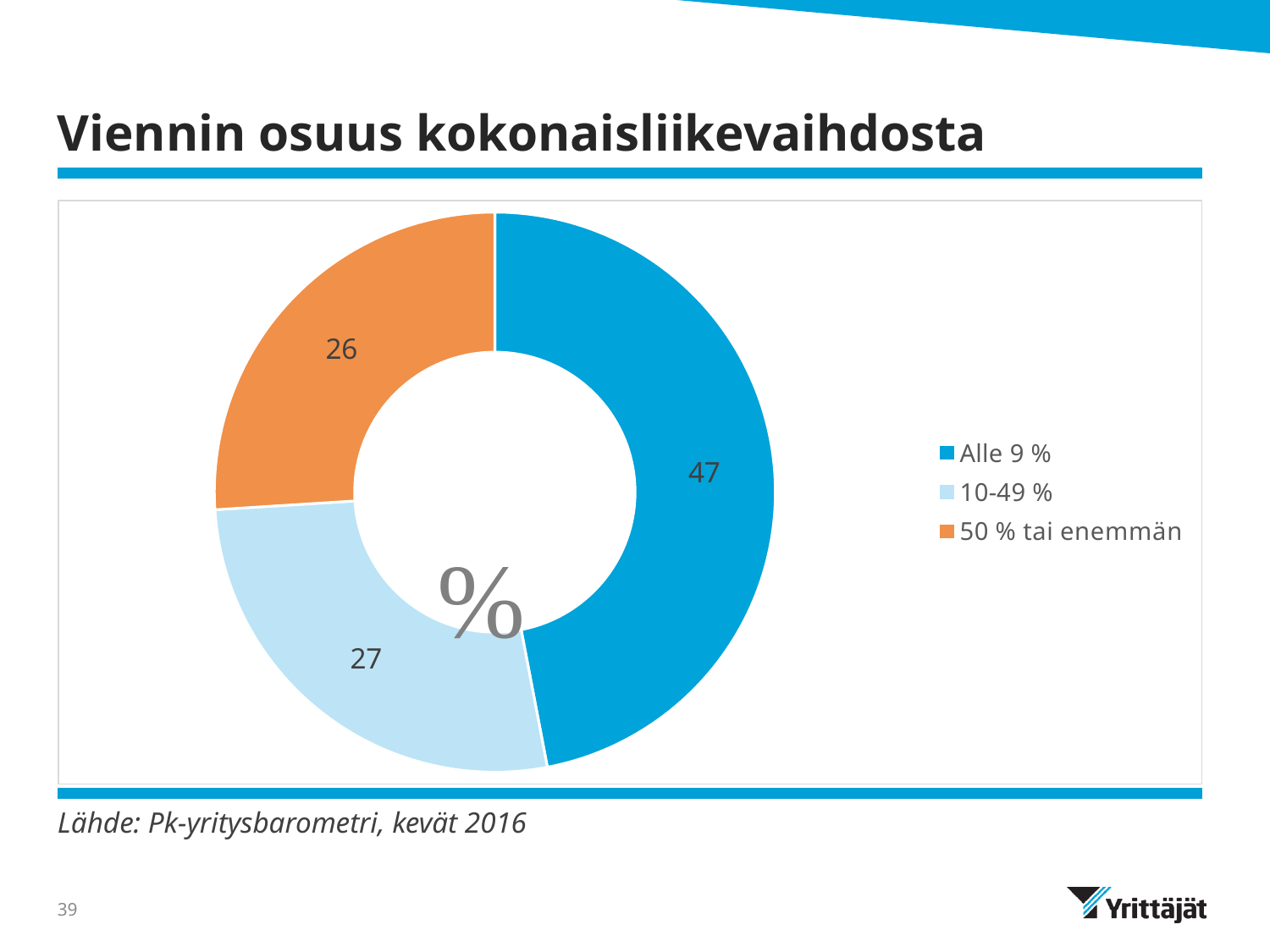
Which colour represents "50 % tai enemmän" in the chart? Orange Which category has the smallest share? 50 % tai enemmän What is the difference between the values for "Alle 9 %" and "10-49 %"? 20 How many categories does the chart show? 3 Which is larger, the value for "Alle 9 %" or the value for "50 % tai enemmän"? Alle 9 % What kind of chart is shown on the slide? Doughnut (pie) chart What is the value for "Alle 9 %"? 47 What is the title of the chart? Viennin osuus kokonaisliikevaihdosta What is the value for "10-49 %"? 27 What is the value for "50 % tai enemmän"? 26 What is the difference between the values for "10-49 %" and "50 % tai enemmän"? 1 Which category has the largest share? Alle 9 %